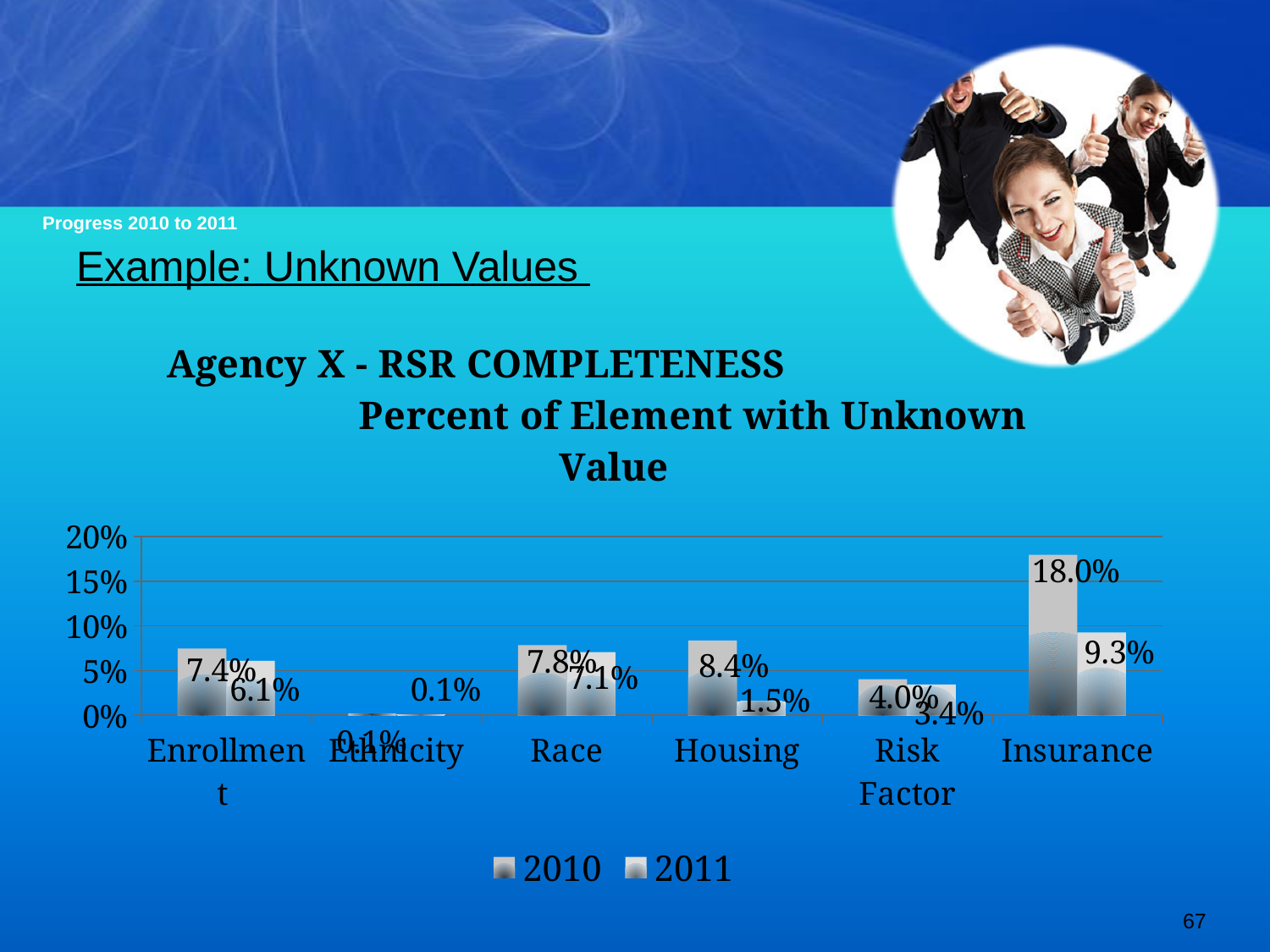
What is the 2011 value for Housing? 1.5% What is the 2011 value for Race? 7.1% What kind of chart is shown on the slide? Bar chart What is the difference between the 2010 and 2011 values for Housing? 6.9% What is the difference between the 2010 and 2011 values for Insurance? 8.7% Which is larger, the 2010 value for Race or the 2010 value for Housing? Housing What is the 2010 value for Enrollment? 7.4% How many series does the legend list? 2 Which category has the highest 2010 value? Insurance Which category has the lowest 2011 value? Ethnicity How many categories are shown on the x axis? 6 What is the 2010 value for Insurance? 18.0%